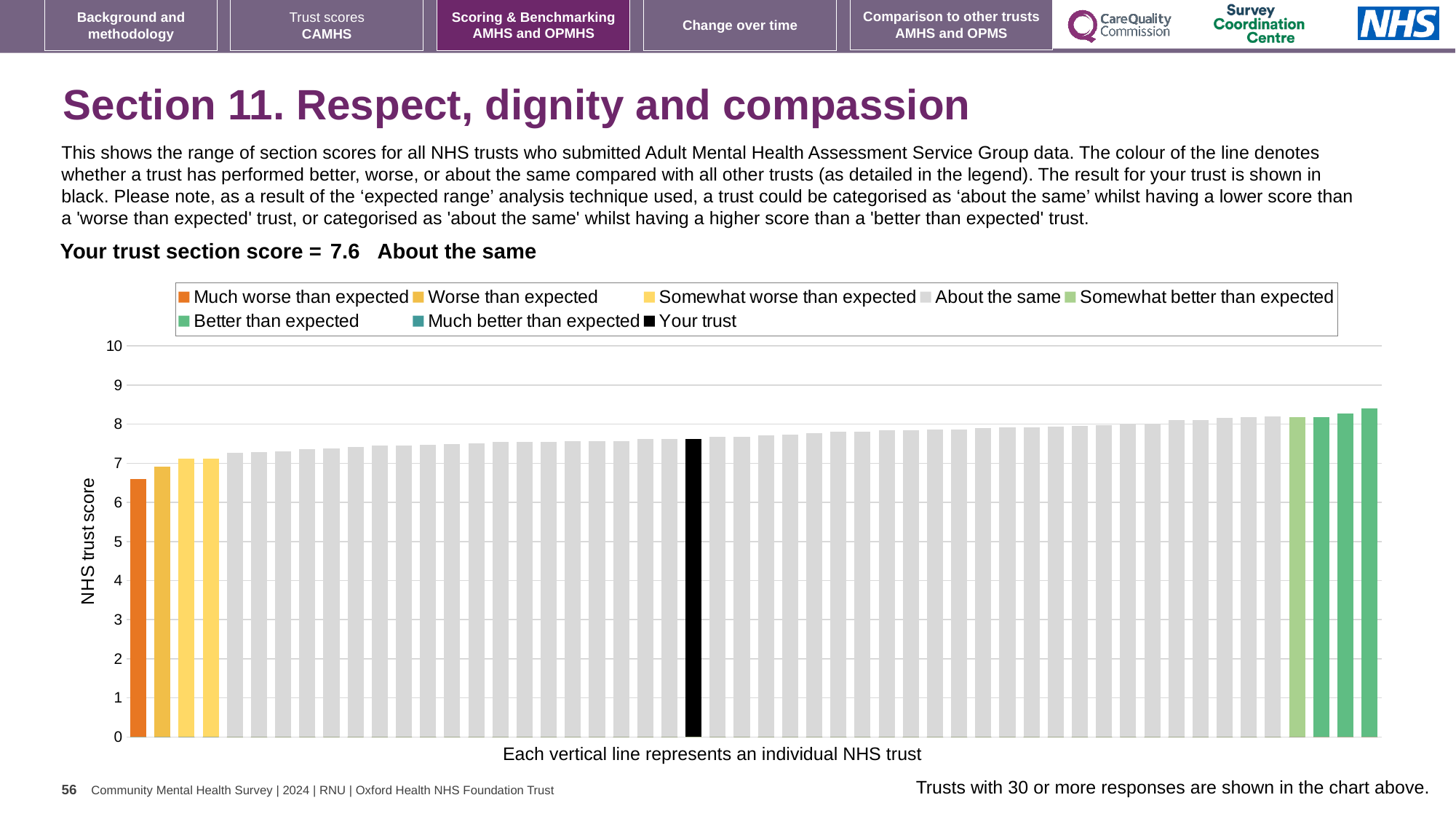
Is the 'Your trust' bar higher or lower than the 'Much worse than expected' bar? higher How many entries does the chart legend list? 8 Do the bar values rise or fall from left to right along the x axis? rise Which legend category does the lowest bar belong to? Much worse than expected Is the value of the rightmost bar greater or less than 8? greater Is the value of the black 'Your trust' bar greater or less than 7? greater Which legend category does the highest bar belong to? Better than expected What kind of chart is shown on the slide? bar chart Is the value of the leftmost (orange) bar greater or less than 7? less What is the label on the vertical axis of the chart? NHS trust score What is the section score for your trust? 7.6 How many bars are coloured as 'Better than expected'? 3